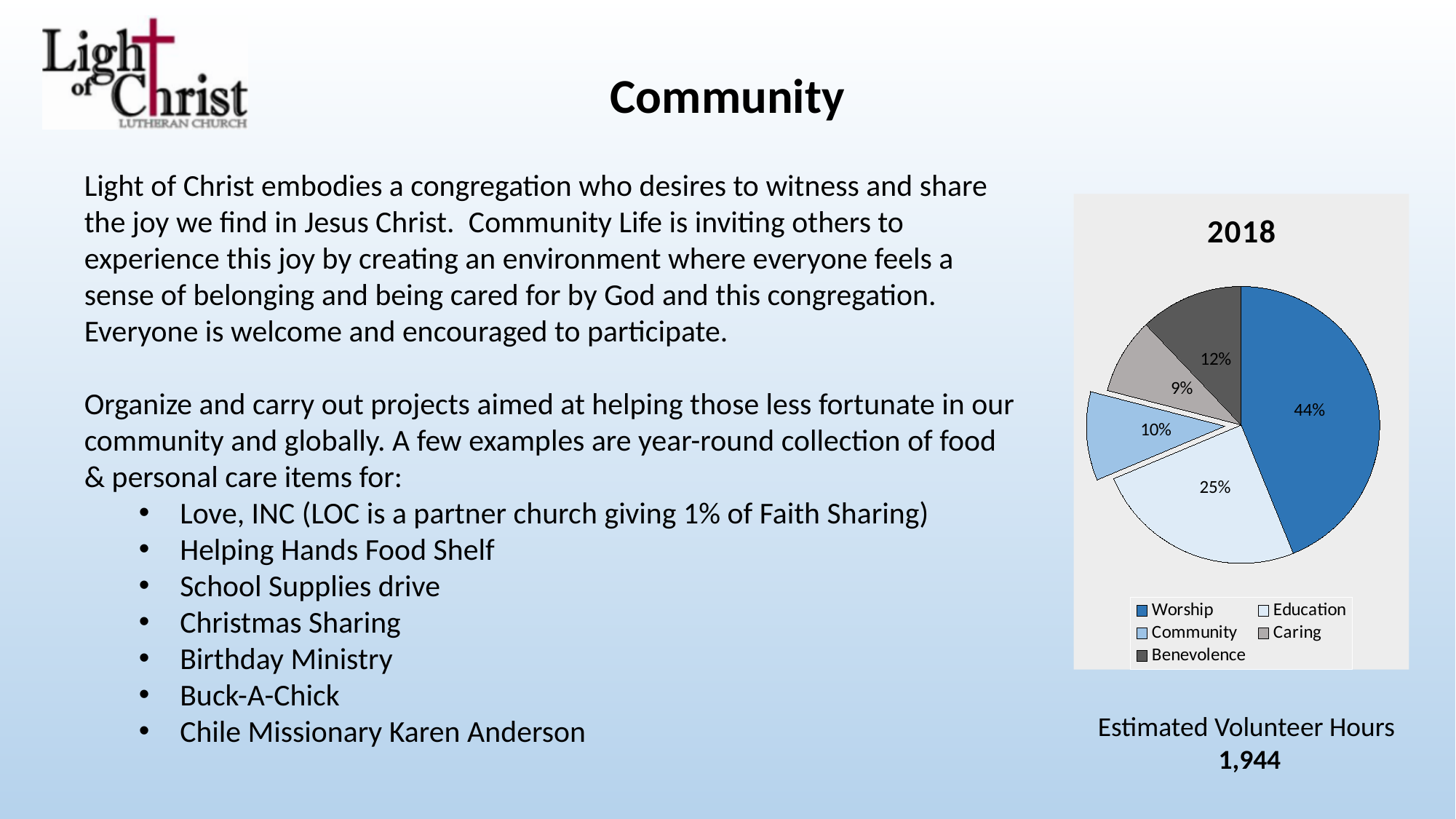
Which is larger, the Benevolence slice or the Community slice? Benevolence What is the title of the pie chart? 2018 What share of the pie does Caring represent? 9% What share of the pie does Benevolence represent? 12% What kind of chart is shown on the slide? pie chart Which category has the smallest slice of the pie? Caring Which category has the largest slice of the pie? Worship What share of the pie does Community represent? 10% What is the difference in percentage points between the Worship and Education slices? 19 How many categories does the pie chart show? 5